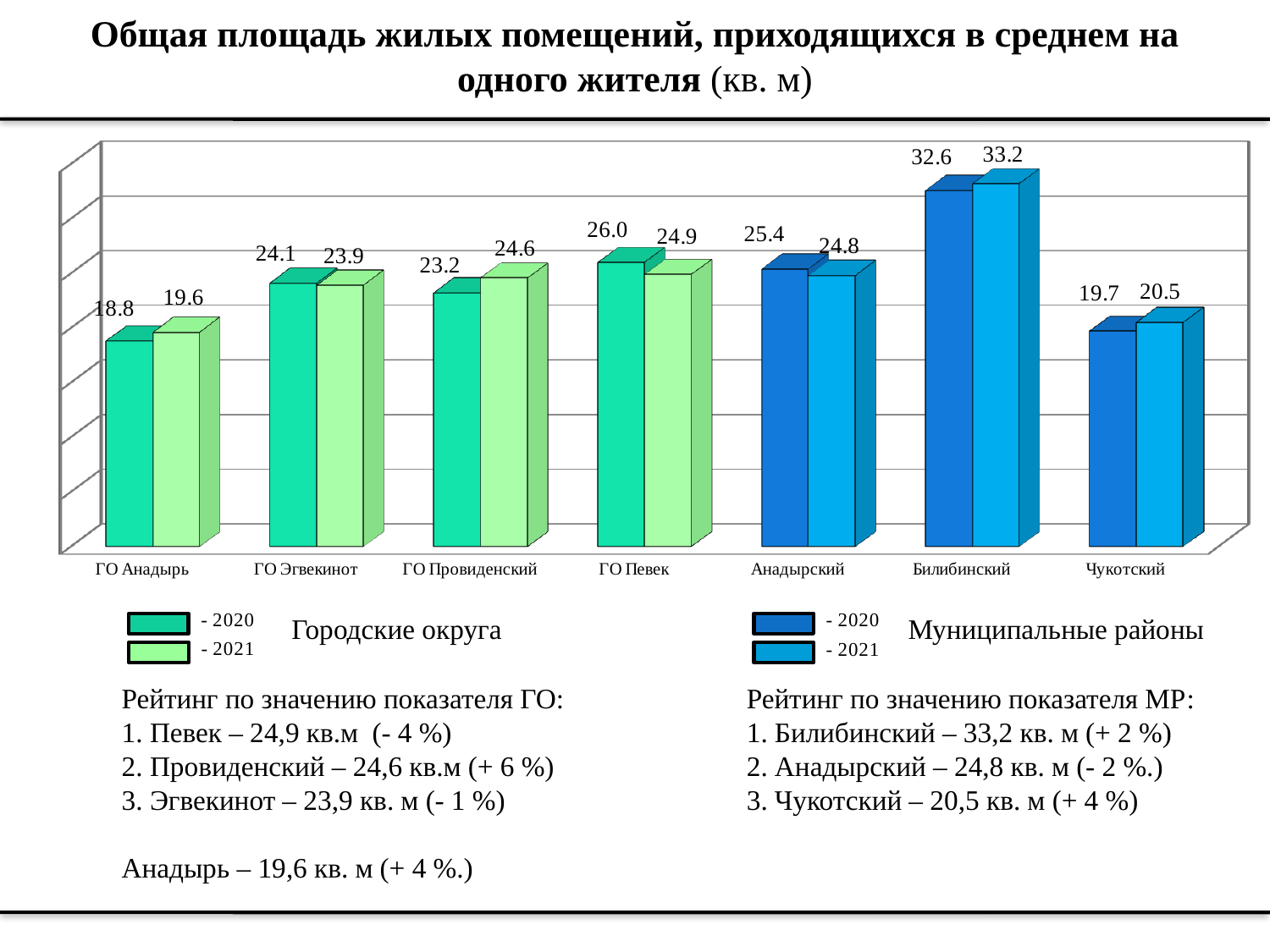
Which category has the highest 2021 value? Билибинский By how much did the value for Билибинский increase from 2020 to 2021? 0.6 What is the difference between the 2021 and 2020 values for ГО Провиденский? 1.4 Which category has the lowest 2020 value? ГО Анадырь Which has the larger 2021 value, ГО Провиденский or ГО Эгвекинот? ГО Провиденский What is the 2020 value for ГО Певек? 26.0 What is the 2021 value for Билибинский? 33.2 What kind of chart is shown on the slide? Bar chart What is the 2020 value for Чукотский? 19.7 Did the value for ГО Певек rise or fall from 2020 to 2021? Fall How many categories are shown on the x axis? 7 Which two years are listed in the legend for Городские округа? 2020 and 2021